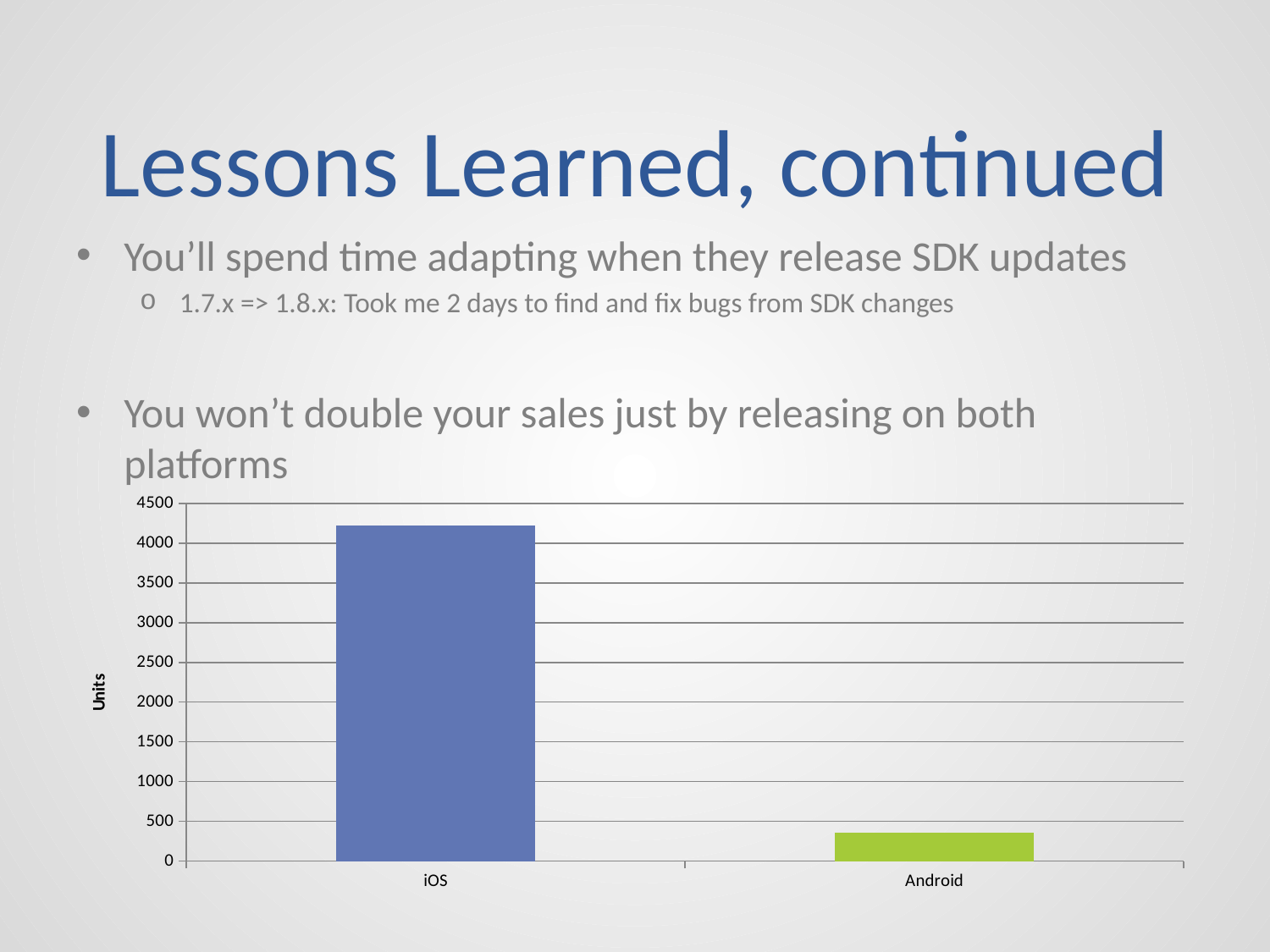
What is the label on the vertical axis of the chart? Units Is the value for Android greater or less than 500? less Do the values rise or fall moving from iOS to Android along the x axis? fall Is the value for iOS greater or less than 4500? less Which category has the lowest value in the chart? Android What is the highest tick value shown on the vertical axis of the chart? 4500 What kind of chart is shown on the slide? bar chart How many categories are plotted on the x axis of the chart? 2 Is the value for Android greater or less than 1000? less Which category has the highest value in the chart? iOS Which is larger, the value for iOS or the value for Android? iOS